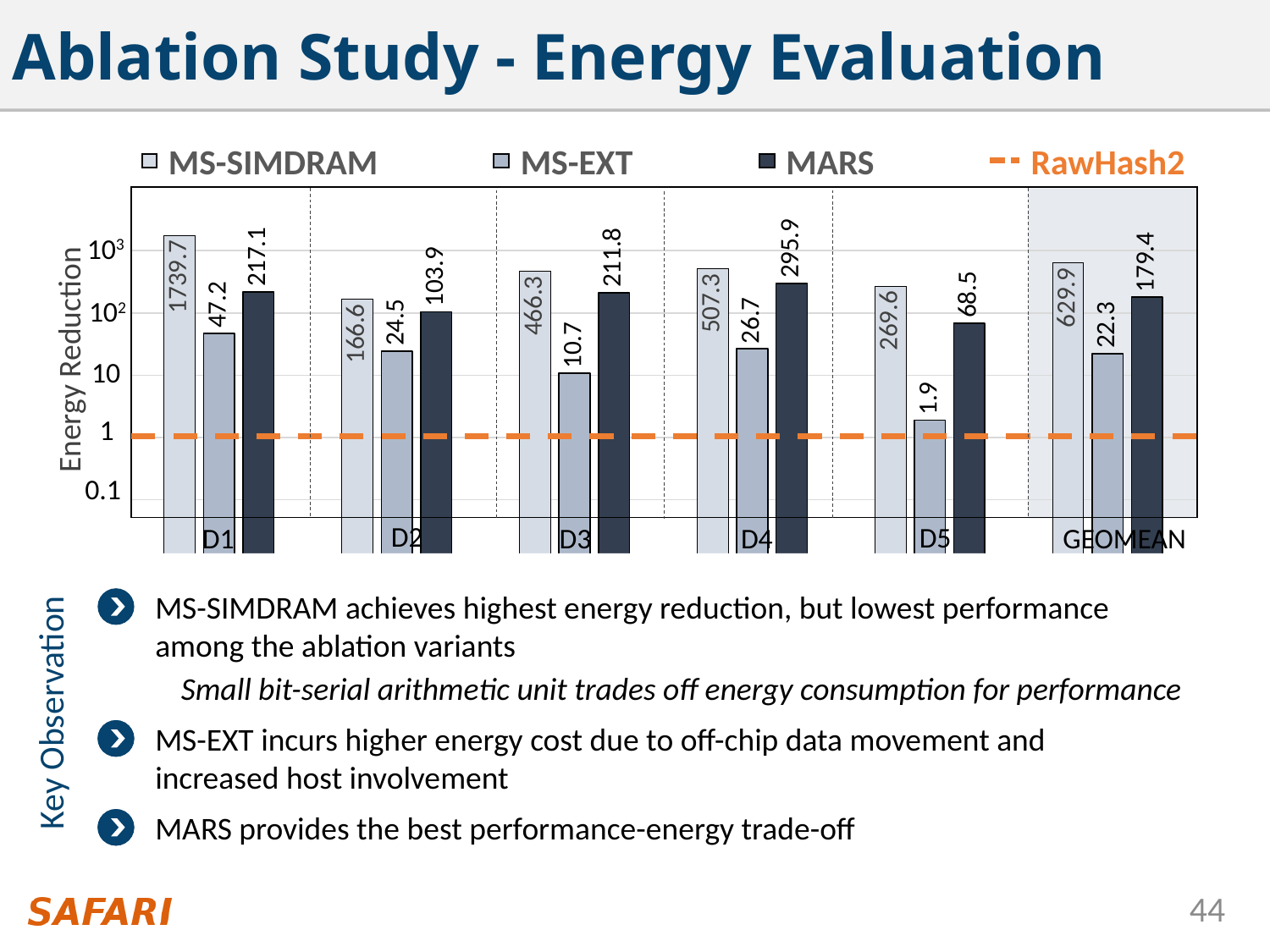
What is the energy reduction value for MARS on D4? 295.9 Which dataset has the lowest MS-EXT energy reduction? D5 What is the energy reduction value for MS-SIMDRAM on D1? 1739.7 Which dataset has the highest MS-SIMDRAM energy reduction? D1 How many entries does the legend list? 4 How many categories are shown on the x axis? 6 What is the energy reduction value for MS-EXT on D5? 1.9 Is the MS-EXT value for D5 greater or less than 10? less What is the difference between the MARS and MS-EXT energy reduction values on D3? 201.1 What is the GEOMEAN energy reduction value for MARS? 179.4 What type of chart is shown on the slide? bar chart Which is larger on D2: the MS-SIMDRAM value or the MARS value? MS-SIMDRAM